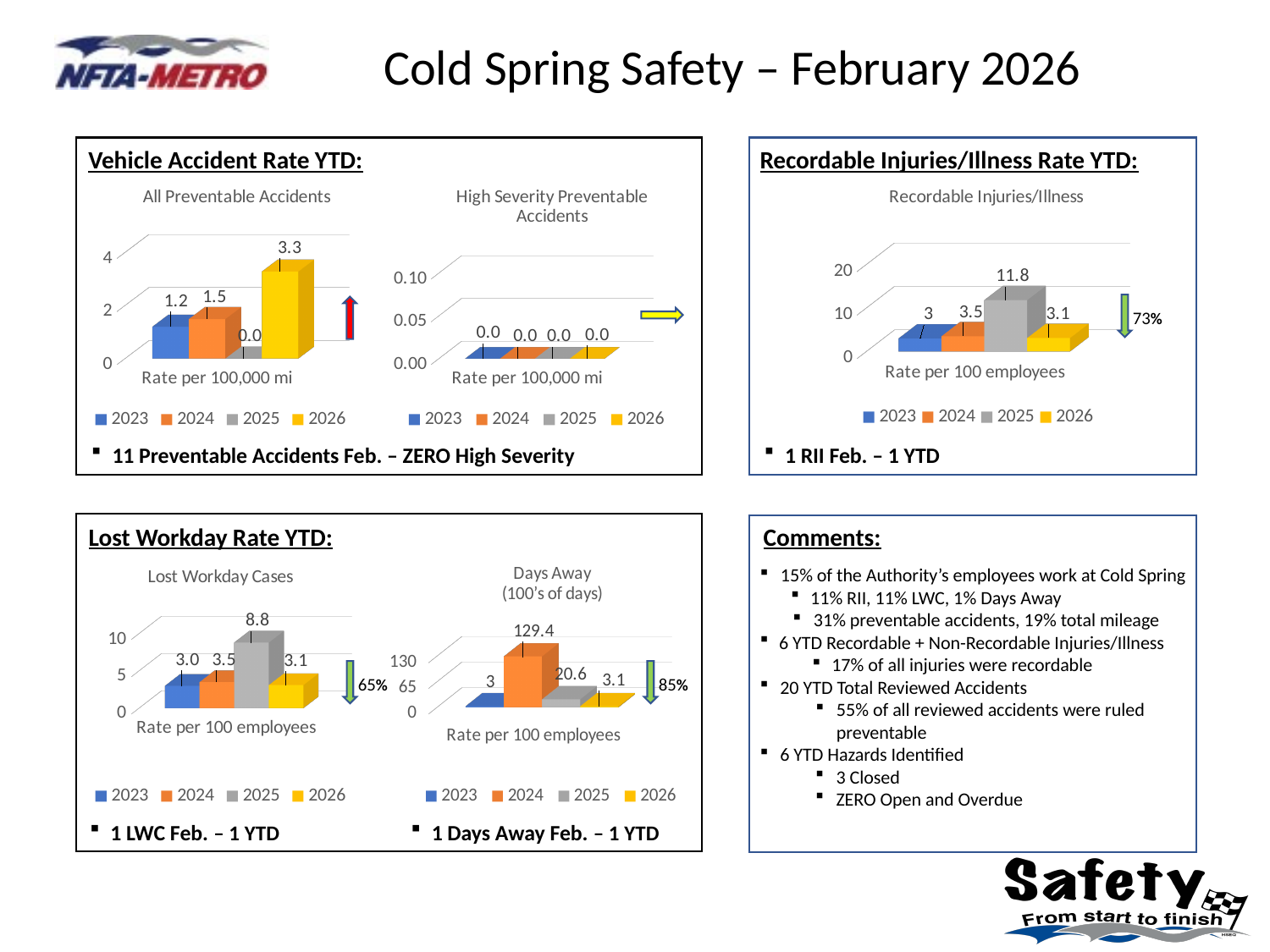
In the All Preventable Accidents chart, which year has the highest value? 2026 In the Recordable Injuries/Illness chart, which year has the lowest value? 2023 In the Recordable Injuries/Illness chart, what is the value for 2025? 11.8 How many series does the legend of the Lost Workday Cases chart list? 4 In the All Preventable Accidents chart, what is the value for 2026? 3.3 In the Lost Workday Cases chart, which is larger, the value for 2024 or the value for 2026? 2024 In the Lost Workday Cases chart, what is the value for 2025? 8.8 In the All Preventable Accidents chart, what is the difference between the 2026 and 2024 values? 1.8 In the High Severity Preventable Accidents chart, what is the value for 2025? 0.0 In the Days Away (100's of days) chart, what is the difference between the 2024 and 2025 values? 108.8 In the Recordable Injuries/Illness chart, is the value for 2025 greater or less than 10? greater In the Days Away (100's of days) chart, what is the value for 2024? 129.4